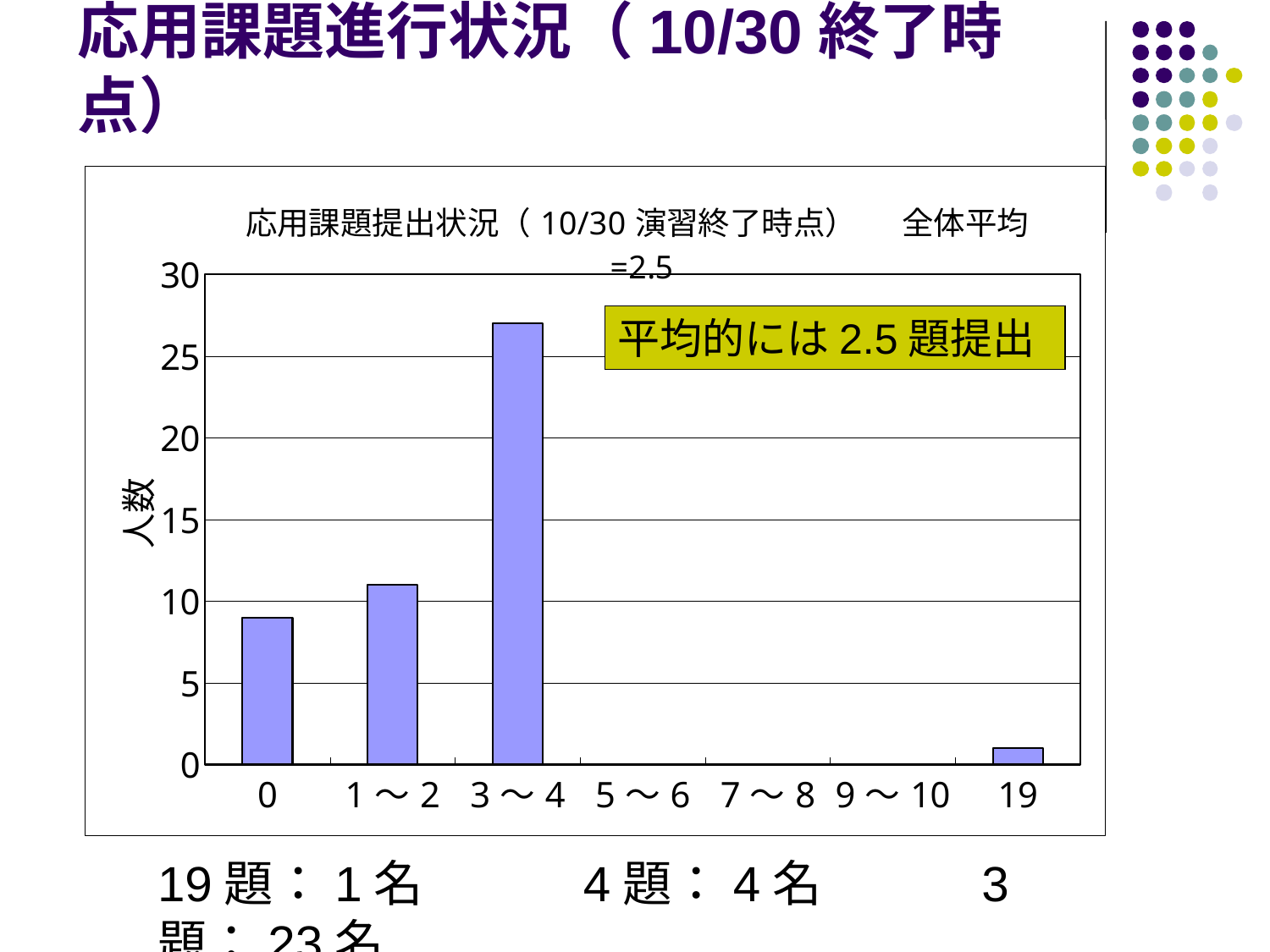
Is the value for 0 greater or less than 10? less Which is larger, the value for 0 or the value for 1～2? 1～2 Is the value for 3～4 greater or less than 25? greater What is the highest value shown on the vertical axis of the chart? 30 Which category has the highest bar in the chart? 3～4 How many categories are shown on the x axis of the chart? 7 What kind of chart is shown on the slide? bar chart Is the value for 19 greater or less than 5? less What is the label on the vertical axis of the chart? 人数 What overall average (全体平均) is stated in the chart title? 2.5 Which is larger, the value for 3～4 or the value for 19? 3～4